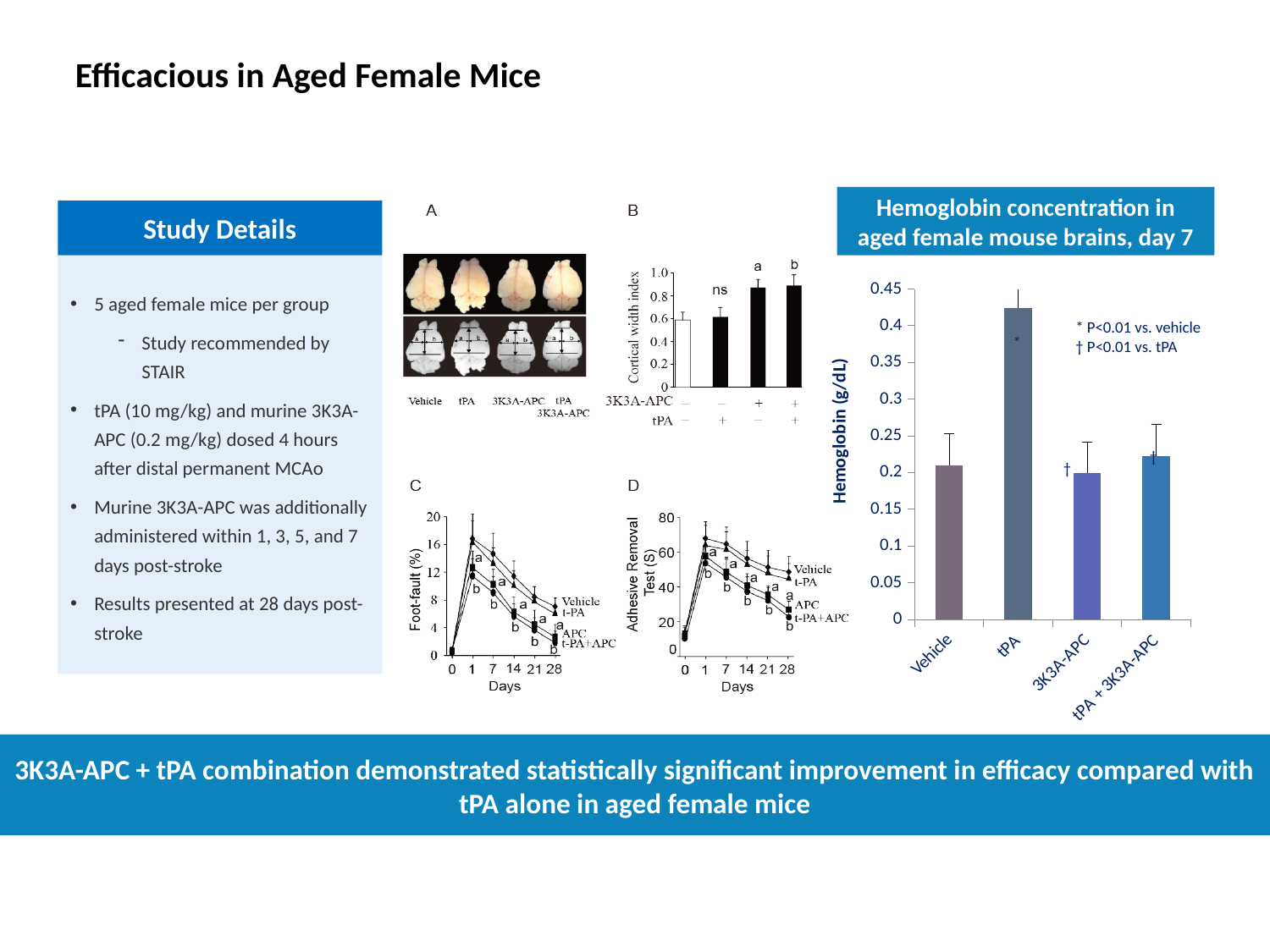
What type of chart is panel B (Cortical width index) of the figure? bar chart In the 'Hemoglobin concentration in aged female mouse brains, day 7' chart, is the value for 3K3A-APC greater or less than 0.25? less What is the y-axis label of the 'Hemoglobin concentration in aged female mouse brains, day 7' chart? Hemoglobin (g/dL) What is the highest tick value shown on the y axis of the 'Hemoglobin concentration in aged female mouse brains, day 7' chart? 0.45 What type of chart is the 'Hemoglobin concentration in aged female mouse brains, day 7' chart? bar chart In panel C (Foot-fault) of the figure, how many time points are labelled on the Days axis? 6 In the 'Hemoglobin concentration in aged female mouse brains, day 7' chart, which group has the highest hemoglobin value? tPA How many groups are shown on the x axis of the 'Hemoglobin concentration in aged female mouse brains, day 7' chart? 4 In the 'Hemoglobin concentration in aged female mouse brains, day 7' chart, is the value for Vehicle greater or less than 0.3? less In the 'Hemoglobin concentration in aged female mouse brains, day 7' chart, which is larger, the value for tPA or the value for Vehicle? tPA In the 'Hemoglobin concentration in aged female mouse brains, day 7' chart, is the value for tPA greater or less than 0.35? greater In panel C (Foot-fault) of the figure, do the values rise or fall from day 1 to day 28? fall